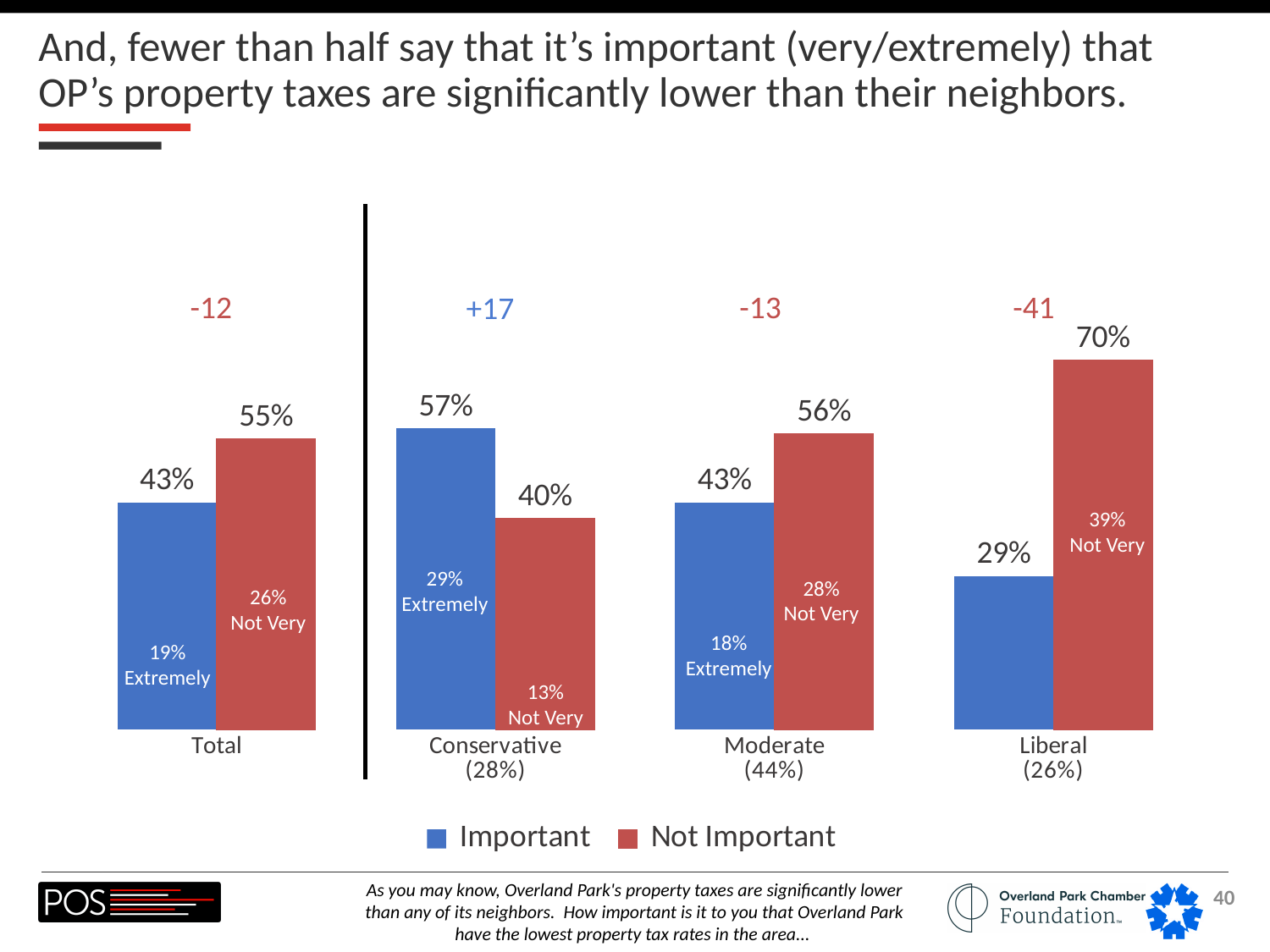
Which group has the highest Not Important value? Liberal What is the difference between Not Important and Important for the Moderate group? 13 What colour represents the Not Important series? Red What is the net difference shown above the Liberal bars? -41 How many series does the legend list? 2 For Conservatives, which is larger: Important or Not Important? Important What kind of chart is shown? Bar chart How many groups are shown on the x axis? 4 Which group has the lowest Important value? Liberal What percentage of Liberals say it is Not Important? 70% What percentage of Conservatives say it is Important? 57% What percentage of the Total group says it is Important? 43%